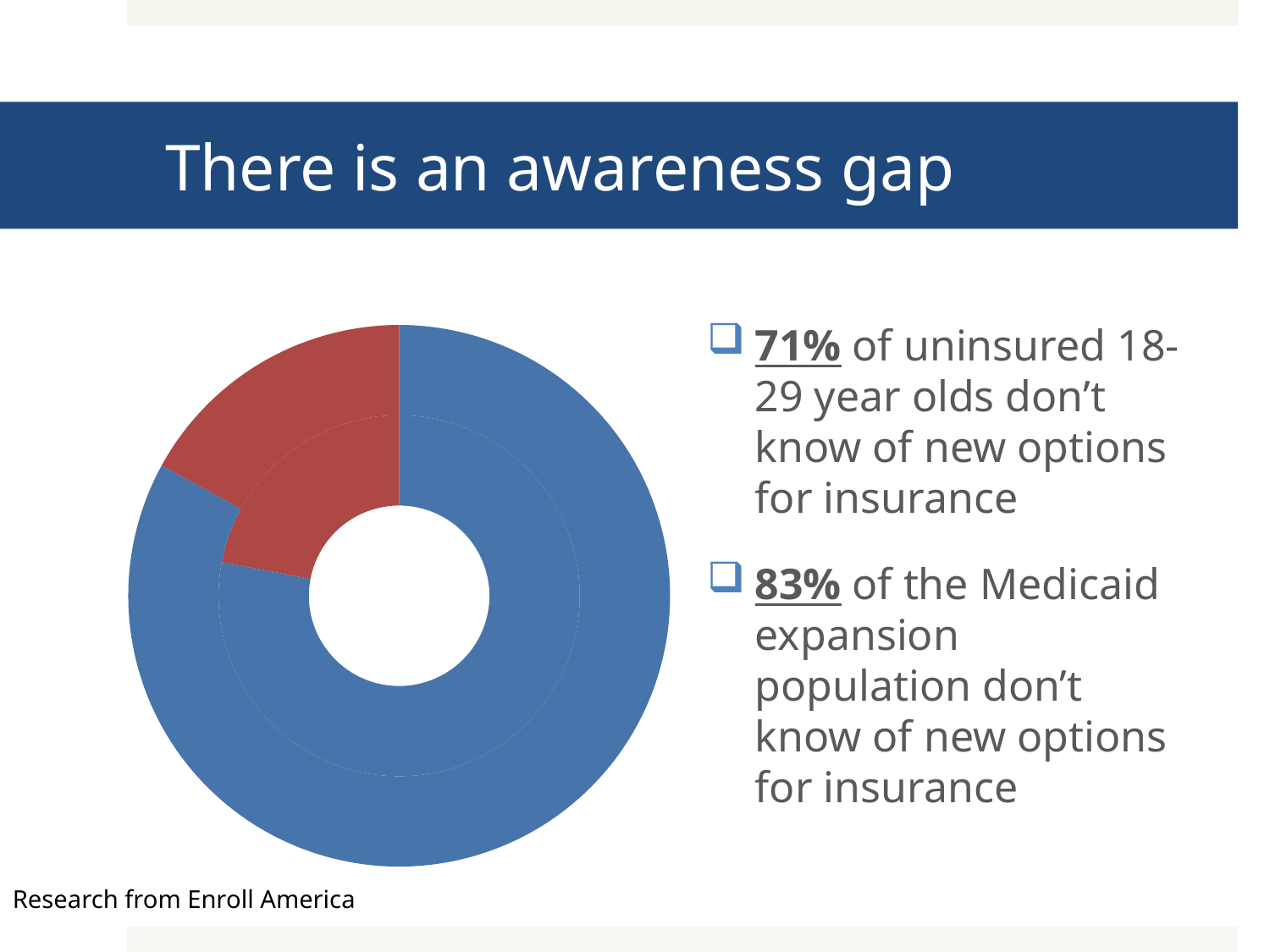
Which colour represents the largest slice in the doughnut chart? Blue Which colour represents the smallest slice in the doughnut chart? Red Is the red slice in the inner ring larger or smaller than the red slice in the outer ring? Larger What kind of chart is shown on the slide? Doughnut (pie) chart Does the doughnut chart display a legend? No Which slice is larger in the outer ring of the doughnut chart, the blue one or the red one? Blue How many rings does the doughnut chart have? 2 Which slice is larger in the inner ring of the doughnut chart, the blue one or the red one? Blue How many slices does each ring of the doughnut chart have? 2